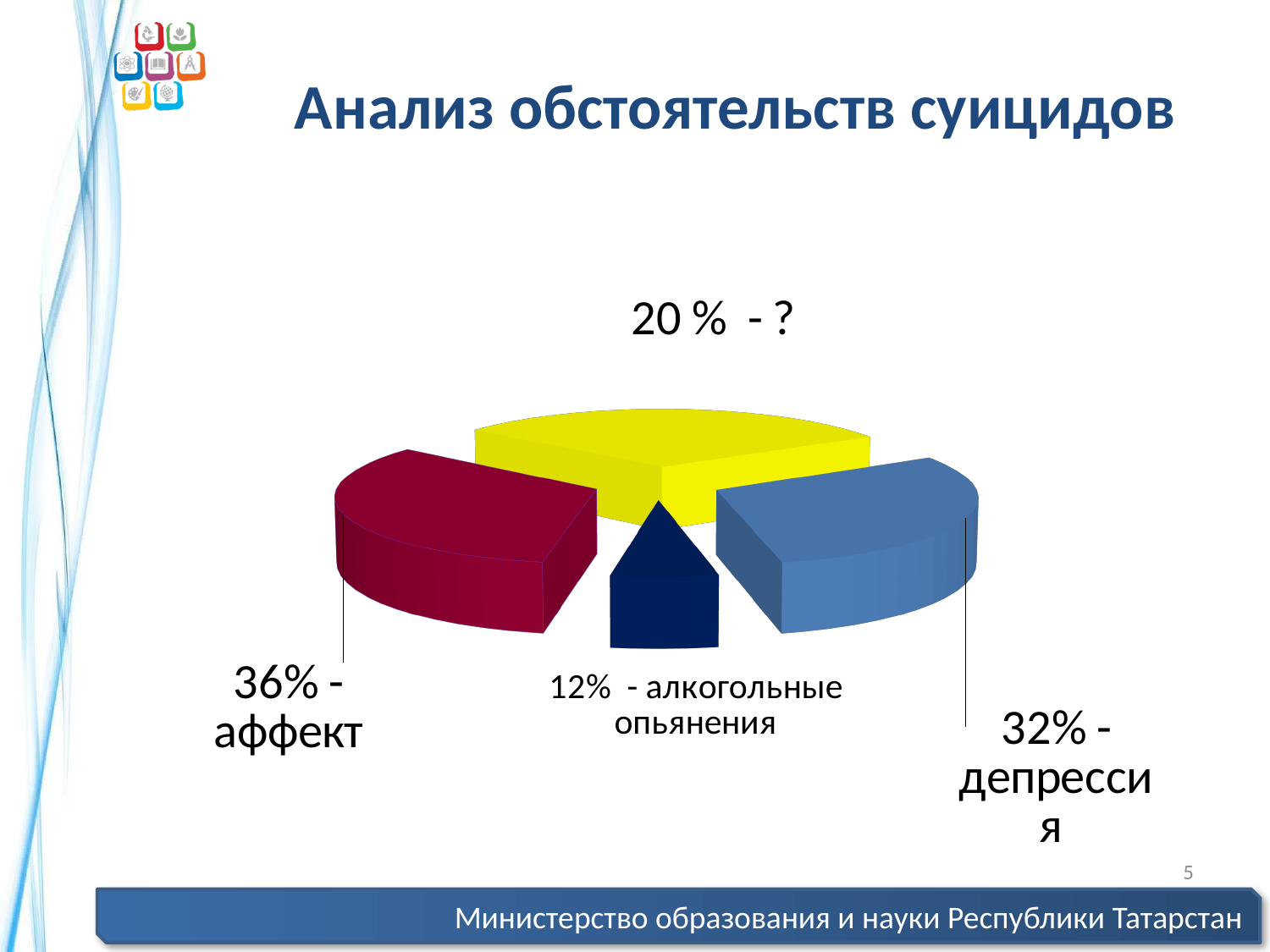
What is the title of the slide containing the pie chart? Анализ обстоятельств суицидов What colour is the slice labelled "аффект"? red Which category has the smallest share of the pie? алкогольные опьянения What type of chart is shown on the slide? pie chart What share of the pie is labelled "депрессия"? 32% Which category has the largest share of the pie? аффект What is the difference in percentage points between "аффект" and "депрессия"? 4 What share of the pie is labelled "алкогольные опьянения"? 12% What share of the pie is labelled "аффект"? 36% Which is larger: the share for "депрессия" or the share for "алкогольные опьянения"? депрессия How many slices does the pie chart have? 4 What percentage is shown for the slice labelled with a question mark ("?")? 20 %